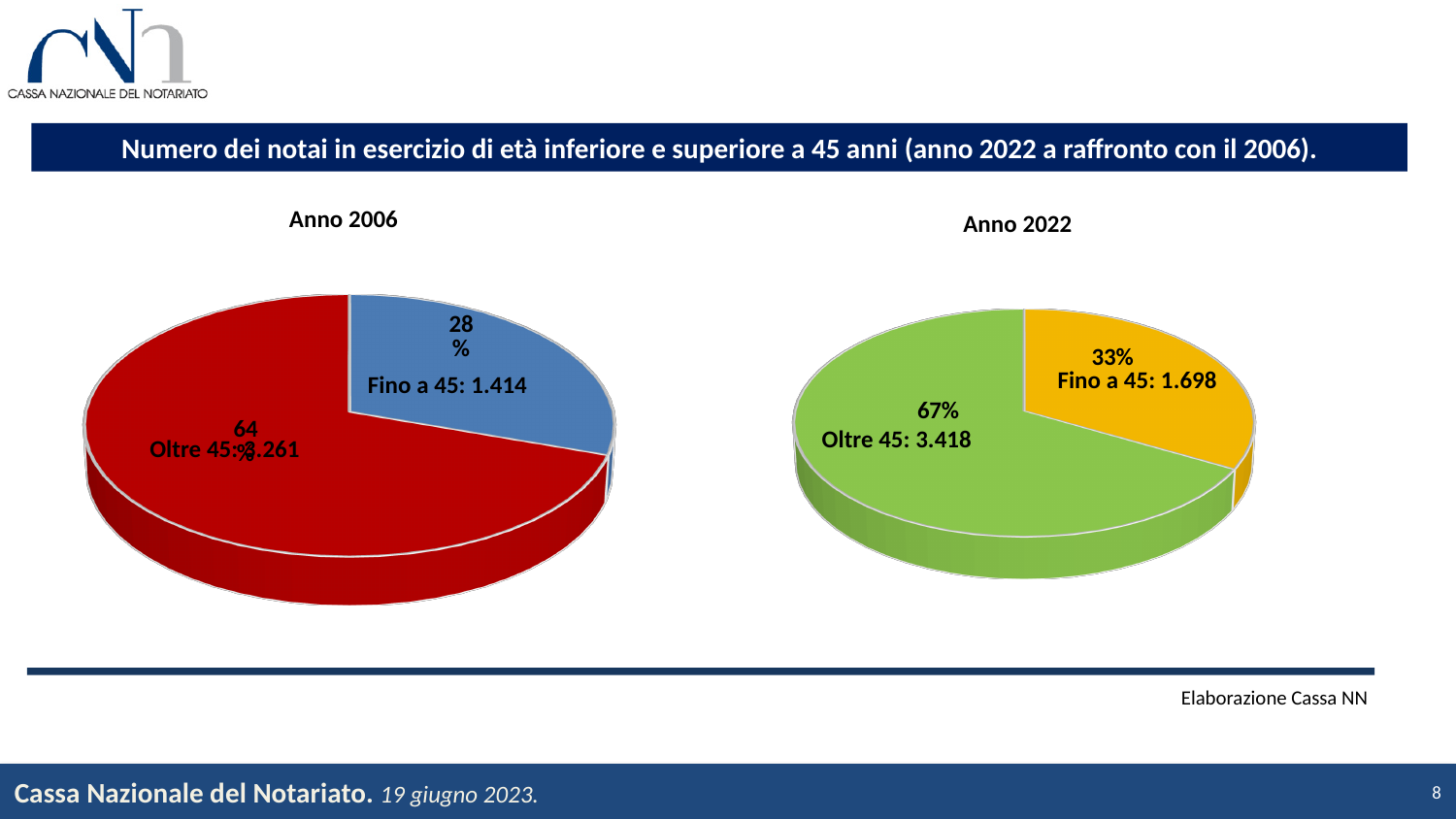
In the Anno 2022 chart, what share of the pie is Fino a 45? 33% In the Anno 2006 chart, what is the value for Oltre 45? 3.261 In the Anno 2022 chart, which category is the largest? Oltre 45 How many slices does the Anno 2022 pie chart have? 2 In the Anno 2006 chart, what share of the pie is Fino a 45? 28% In the Anno 2022 chart, what is the value for Oltre 45? 3.418 In the Anno 2022 chart, what is the value for Fino a 45? 1.698 In the Anno 2006 chart, what is the value for Fino a 45? 1.414 Is the value for Fino a 45 larger in the Anno 2006 chart or in the Anno 2022 chart? Anno 2022 In the Anno 2022 chart, what is the difference between Oltre 45 and Fino a 45? 1.720 In the Anno 2022 chart, what share of the pie is Oltre 45? 67% What kind of chart is used for Anno 2006? pie chart